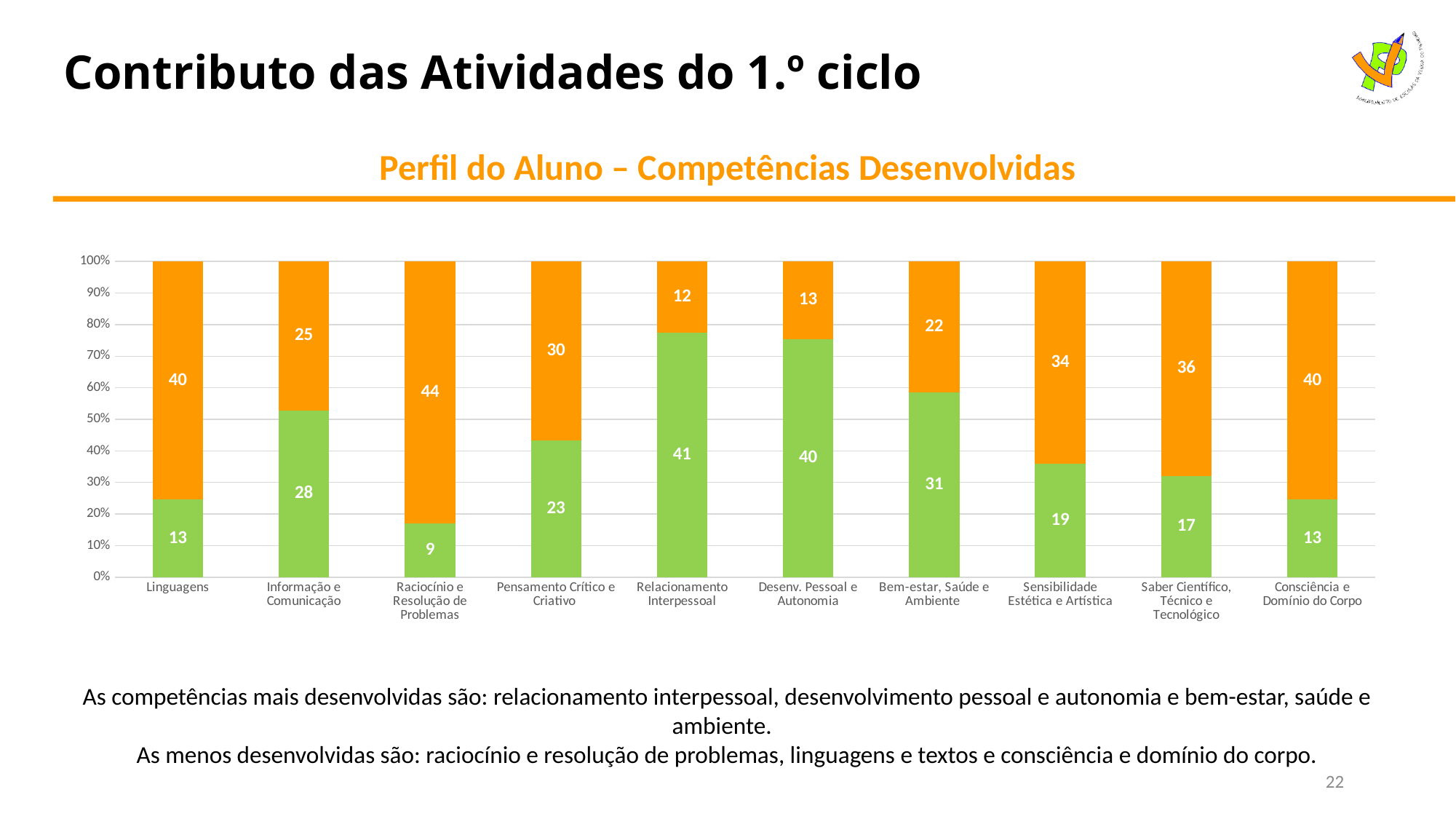
Which is larger for Informação e Comunicação: the green segment or the orange segment? Green segment What is the difference between the orange and green segment values for Linguagens? 27 What is the total of the green and orange segments for Bem-estar, Saúde e Ambiente? 53 What is the title shown above the chart? Perfil do Aluno – Competências Desenvolvidas What type of chart is shown on the slide? Stacked bar chart Which category has the lowest green segment value? Raciocínio e Resolução de Problemas How many categories are shown on the x axis of the chart? 10 What is the green segment value for Relacionamento Interpessoal? 41 Is the green segment for Desenv. Pessoal e Autonomia greater or less than 70% of the bar? greater What is the orange segment value for Raciocínio e Resolução de Problemas? 44 What is the green segment value for Saber Científico, Técnico e Tecnológico? 17 Which category has the highest green segment value? Relacionamento Interpessoal